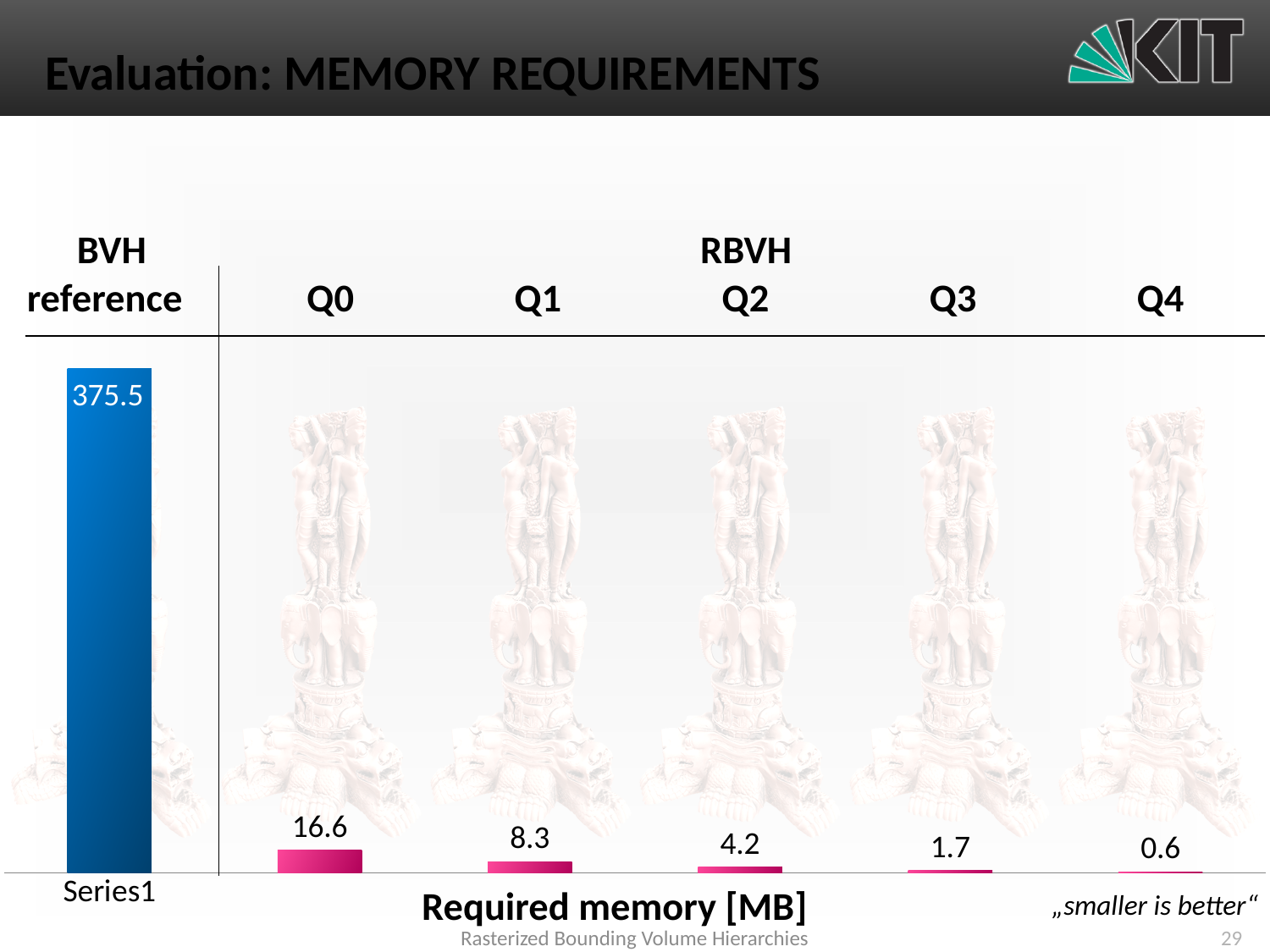
Which requires more memory, Q1 or Q3? Q1 Which category has the highest required memory? BVH reference What is the required memory for Q4? 0.6 What is the difference in required memory between Q3 and Q4? 1.1 Which category has the lowest required memory? Q4 What is the difference in required memory between Q0 and Q1? 8.3 What is the required memory for Q2? 4.2 What is the required memory for Q0? 16.6 How many bars are shown in the chart? 6 What is the required memory for the BVH reference? 375.5 Do the required memory values rise or fall from Q0 to Q4? Fall What kind of chart is shown on the slide? Bar chart